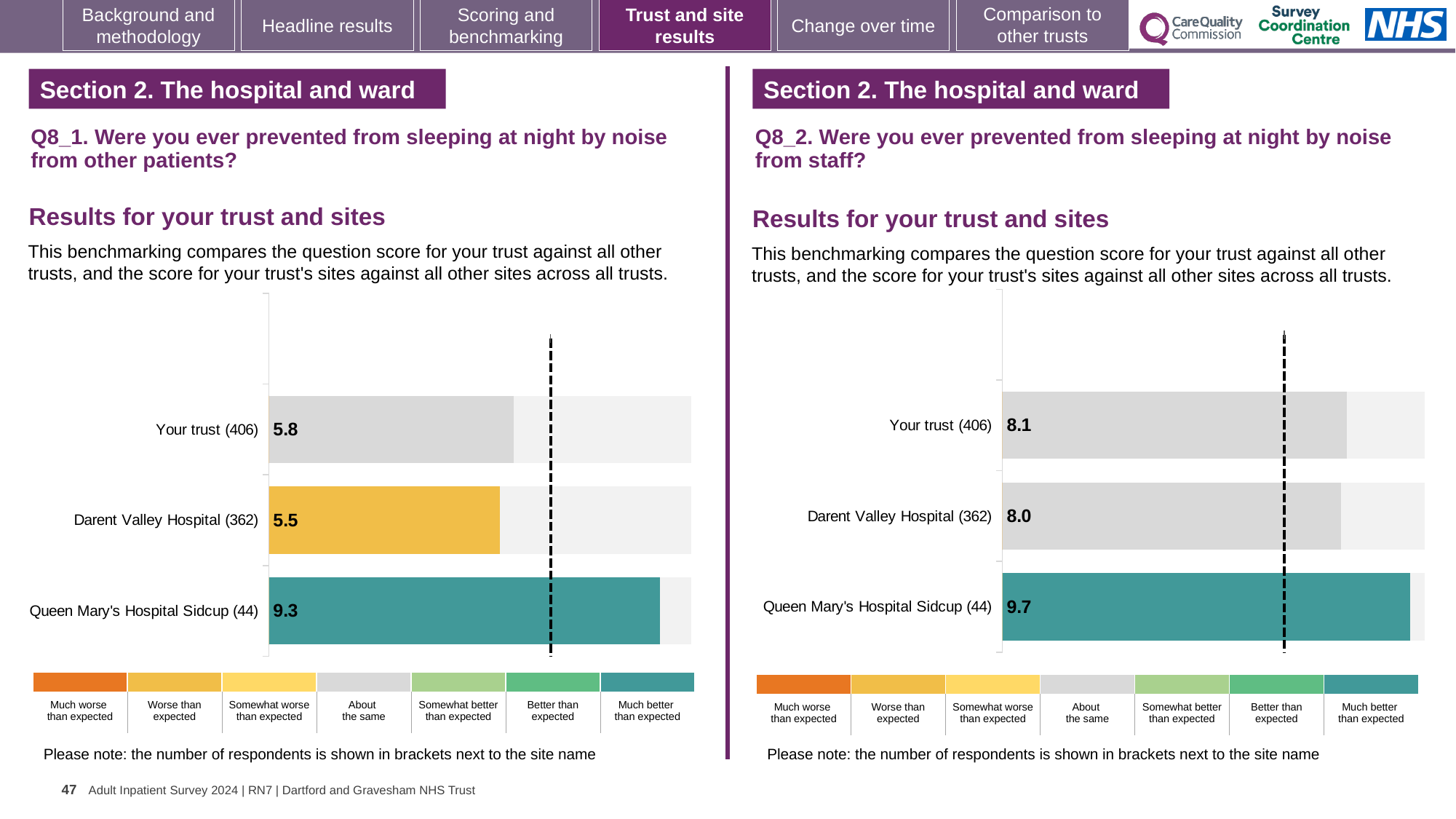
On the Q8_2 chart (noise from staff), which site has the lowest score? Darent Valley Hospital On the Q8_1 chart (noise from other patients), how many bars are plotted? 3 What kind of chart is used on the Q8_1 chart (noise from other patients)? Bar chart On the Q8_2 chart (noise from staff), what is the score for Your trust? 8.1 On the Q8_2 chart (noise from staff), what is the difference between the scores for Queen Mary's Hospital Sidcup and Your trust? 1.6 On the Q8_1 chart (noise from other patients), what colour is the bar for Darent Valley Hospital? Yellow/orange On the Q8_1 chart (noise from other patients), what is the score for Darent Valley Hospital? 5.5 On the Q8_1 chart (noise from other patients), what is the difference between the scores for Queen Mary's Hospital Sidcup and Darent Valley Hospital? 3.8 On the Q8_2 chart (noise from staff), what is the score for Queen Mary's Hospital Sidcup? 9.7 On the Q8_1 chart (noise from other patients), what is the score for Your trust? 5.8 Which is larger: the Darent Valley Hospital score on the Q8_1 chart or the Darent Valley Hospital score on the Q8_2 chart? Q8_2 chart On the Q8_1 chart (noise from other patients), which site has the highest score? Queen Mary's Hospital Sidcup